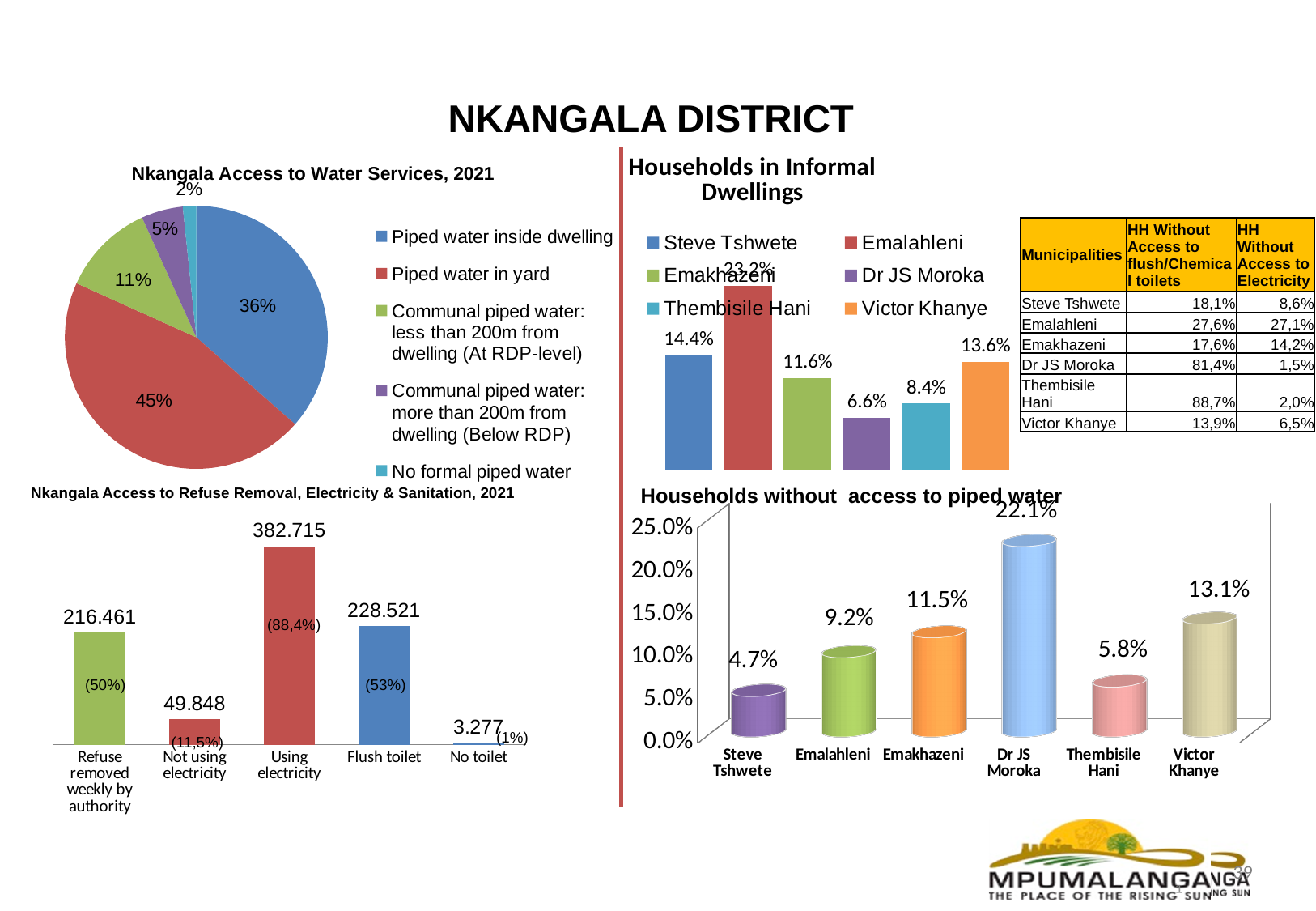
In the 'Nkangala Access to Refuse Removal, Electricity & Sanitation, 2021' chart, what is the value for 'Using electricity'? 382.715 What kind of chart is 'Nkangala Access to Refuse Removal, Electricity & Sanitation, 2021'? Bar chart In the 'Households without access to piped water' chart, what is the value for Dr JS Moroka? 22.1% How many municipalities are shown in the 'Households without access to piped water' chart? 6 How many legend entries does the 'Nkangala Access to Water Services, 2021' pie chart list? 5 In the 'Households in Informal Dwellings' chart, what is the value for Emalahleni? 23.2% In the 'Households in Informal Dwellings' chart, which municipality has the lowest value? Dr JS Moroka In the 'Households without access to piped water' chart, which is larger, Emakhazeni or Victor Khanye? Victor Khanye In the 'Nkangala Access to Water Services, 2021' pie chart, what share is shown for 'Piped water in yard'? 45% In the 'Nkangala Access to Refuse Removal, Electricity & Sanitation, 2021' chart, which category has the lowest value? No toilet In the 'Nkangala Access to Refuse Removal, Electricity & Sanitation, 2021' chart, what is the difference between 'Flush toilet' and 'Refuse removed weekly by authority'? 12.060 In the 'Nkangala Access to Water Services, 2021' pie chart, which category has the smallest slice? No formal piped water